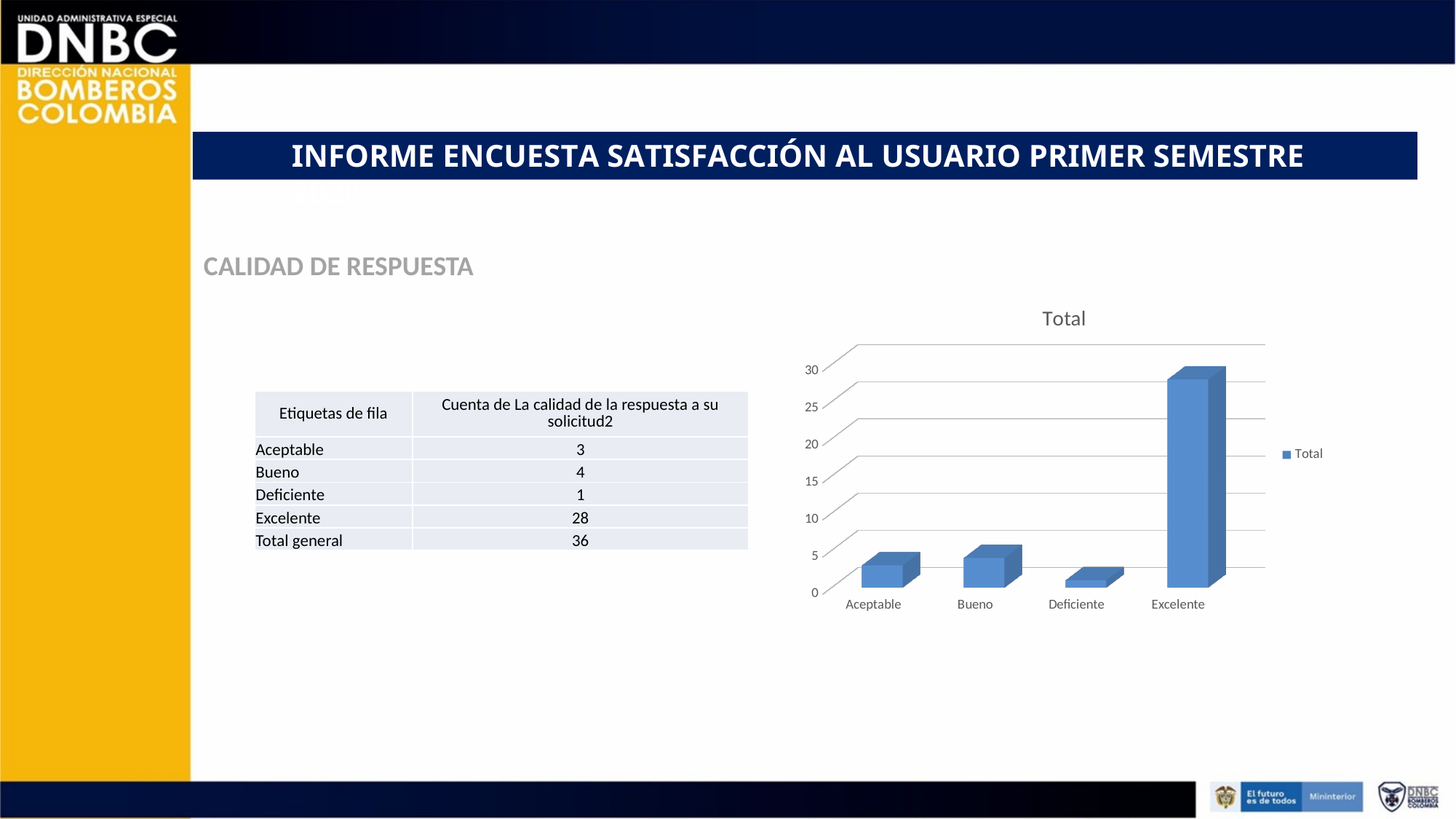
What kind of chart is shown on the slide? bar chart Is the value for Excelente in the chart greater or less than 25? greater What is the title of the chart? Total Which category has the lowest bar in the chart? Deficiente According to the table on the slide, what is the count for Aceptable? 3 Is the value for Bueno in the chart greater or less than 5? less According to the table on the slide, what is the count for Bueno? 4 According to the table on the slide, what is the count for Excelente? 28 How many categories are shown on the x axis of the chart? 4 How many series does the chart legend list? 1 Which category has the highest bar in the chart? Excelente Using the values in the table, what is the difference between Excelente and Bueno? 24